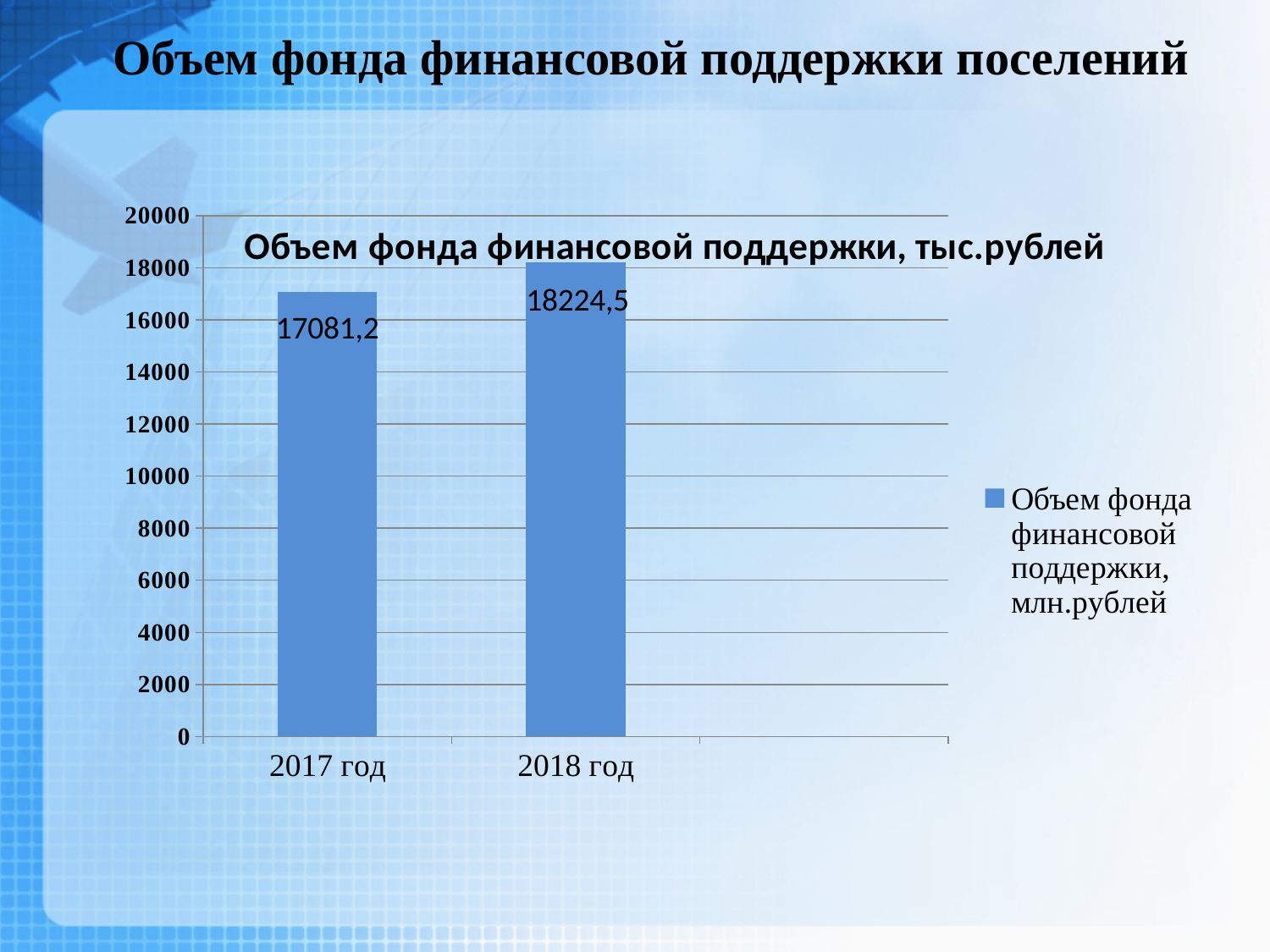
Which year has the highest value? 2018 год What is the difference between the values for 2018 год and 2017 год? 1143,3 How many categories are shown on the x axis? 2 What kind of chart is shown? bar chart Is the value for 2017 год greater or less than 18000? less Do the values rise or fall from 2017 год to 2018 год? rise How many series does the legend list? 1 Is the value for 2018 год greater or less than 18000? greater What is the value for 2018 год? 18224,5 Which is larger, the value for 2017 год or 2018 год? 2018 год Which year has the lowest value? 2017 год What is the value for 2017 год? 17081,2